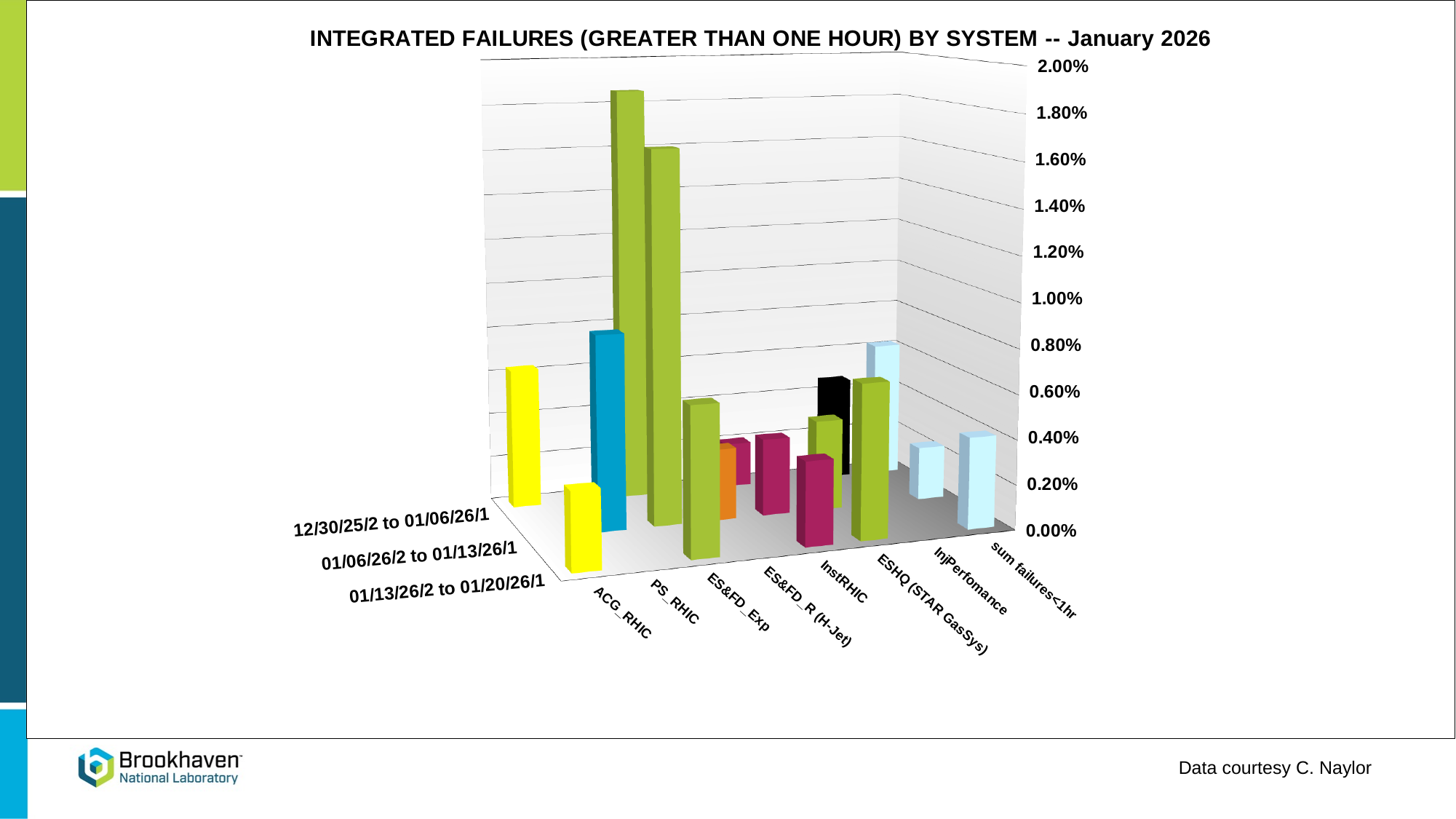
What kind of chart is shown on the slide? bar chart Which time period is listed first (at the back) on the depth axis of the chart? 12/30/25/2 to 01/06/26/1 What is the highest value shown on the vertical axis of the chart? 2.00% Is the value for InjPerfomance greater or less than 1.00%? less How many time periods (rows of bars) does the chart show? 3 Which system has the tallest bar in the chart? ES&FD_Exp Which is larger, the tallest bar for PS_RHIC or the tallest bar for ACG_RHIC? PS_RHIC Is the value for ES&FD_R (H-Jet) greater or less than 1.00%? less What is the title of the chart? INTEGRATED FAILURES (GREATER THAN ONE HOUR) BY SYSTEM -- January 2026 Is the tallest bar for PS_RHIC greater or less than 1.40%? less How many system categories are shown along the x axis of the chart? 8